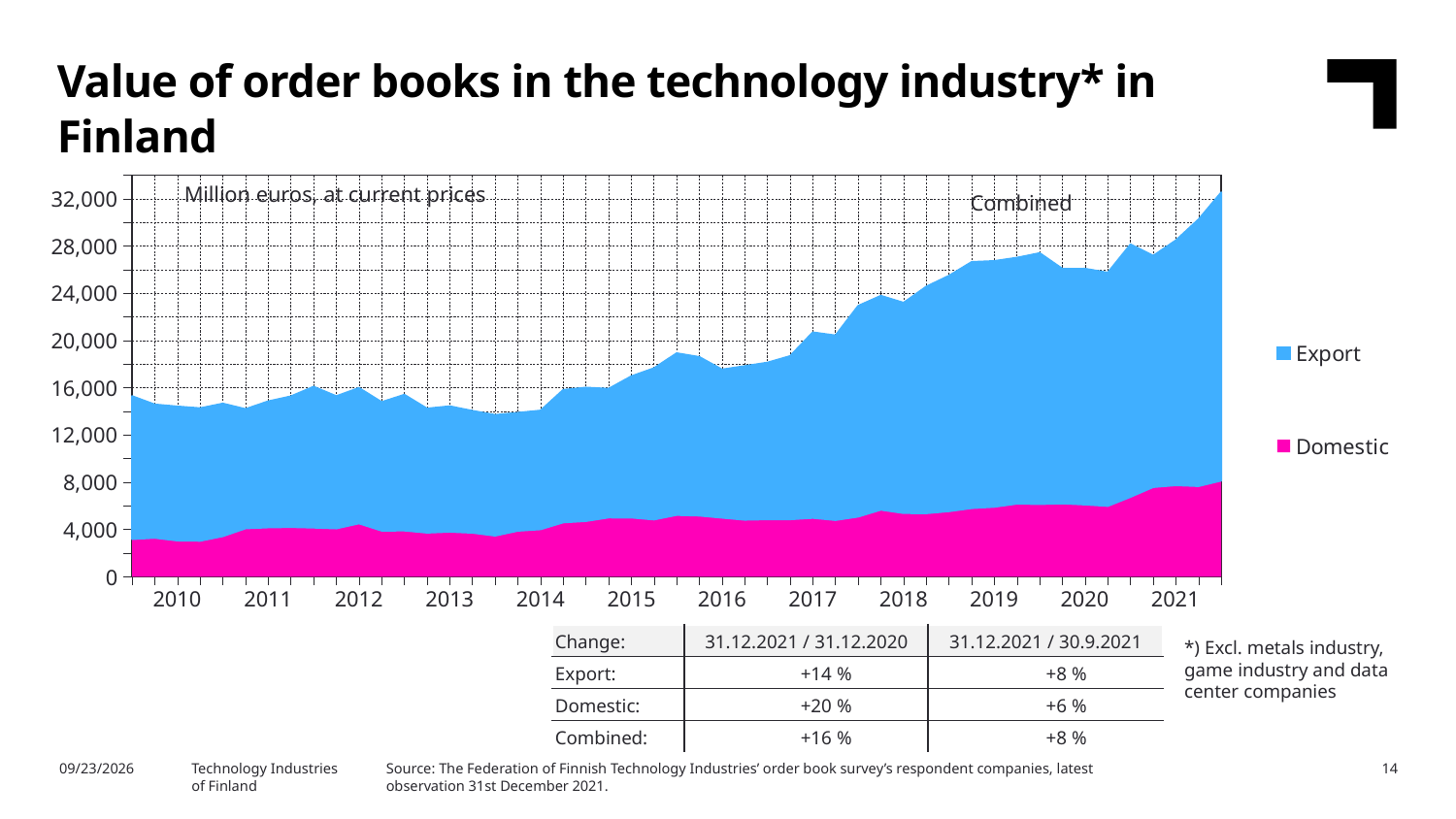
How many years are labelled on the x axis of the chart? 12 What kind of chart is shown on the slide? Stacked area chart What unit is the chart's data expressed in, according to the label inside the plot area? Million euros, at current prices Which two series are listed in the chart legend? Export and Domestic Which series is larger in 2021, Export or Domestic? Export Is the combined value at the start of 2019 greater or less than 24,000? greater Does the combined value of order books generally rise or fall from 2010 to 2021? Rise Is the Domestic value at the start of 2020 greater or less than 8,000? less How many series does the chart legend list? 2 Is the combined value at the start of 2014 greater or less than 16,000? less